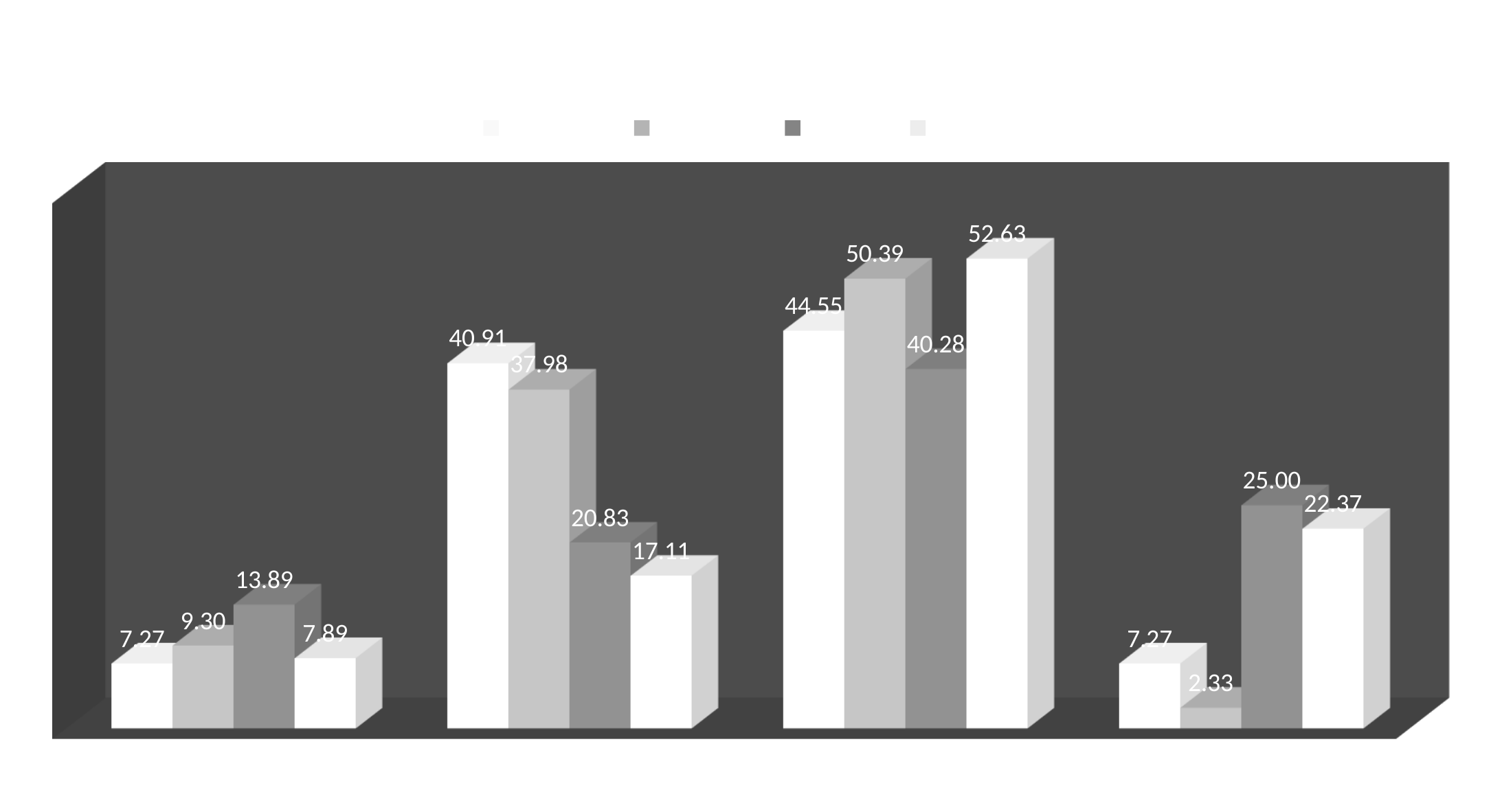
What is the value of the third bar in the rightmost group? 25.00 How many groups of bars are plotted in the chart? 4 In the third group from the left, what is the difference between the fourth bar (52.63) and the third bar (40.28)? 12.35 In the second group from the left, what is the difference between the first bar (40.91) and the second bar (37.98)? 2.93 How many bars are in each group? 4 In the third group from the left, which is larger: the second bar or the fourth bar? the fourth bar (52.63) What is the highest value labelled on the chart? 52.63 How many series does the legend list? 4 What is the lowest value labelled on the chart? 2.33 In the rightmost group, what is the difference between the third bar (25.00) and the fourth bar (22.37)? 2.63 What is the value of the third bar in the leftmost group? 13.89 What kind of chart is shown on the slide? bar chart